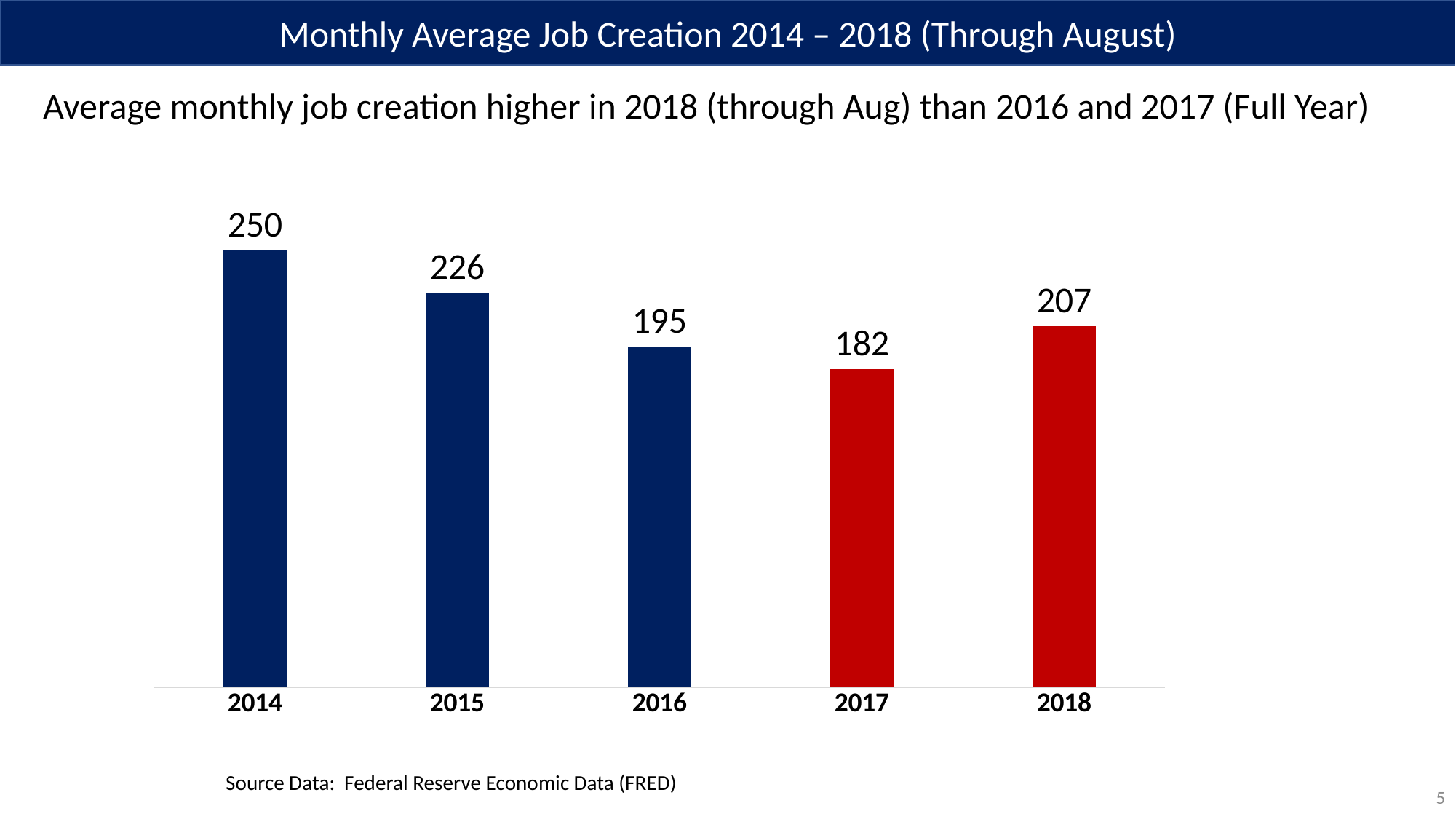
What kind of chart is shown on the slide? Bar chart What is the difference between the 2018 and 2017 values? 25 Do the values rise or fall from 2014 to 2017? Fall What is the difference between the 2014 and 2015 values? 24 Which years are shown with red bars? 2017 and 2018 Which is larger, the value for 2016 or the value for 2018? 2018 What is the monthly average job creation value for 2017? 182 What is the monthly average job creation value for 2018? 207 What is the monthly average job creation value for 2014? 250 Which year has the lowest monthly average job creation? 2017 Which year has the highest monthly average job creation? 2014 How many years are shown on the chart? 5